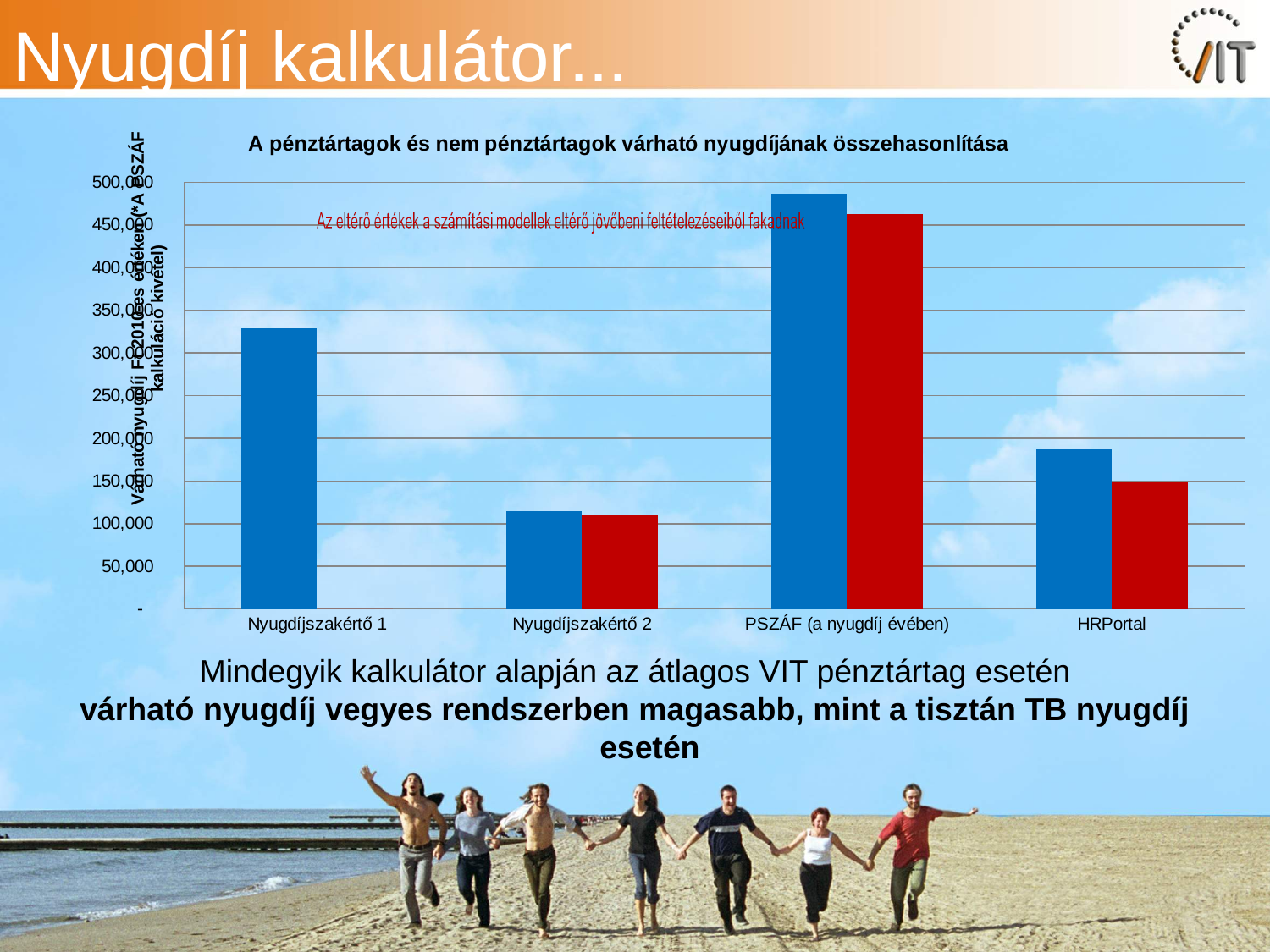
What is the title of the chart? A pénztártagok és nem pénztártagok várható nyugdíjának összehasonlítása Which is larger: the blue bar for Nyugdíjszakértő 1 or the blue bar for HRPortal? Nyugdíjszakértő 1 Is the blue bar for Nyugdíjszakértő 2 greater or less than 150,000? less Which category has the tallest blue bar? PSZÁF (a nyugdíj évében) Which category has the shortest blue bar? Nyugdíjszakértő 2 What kind of chart is shown on the slide? bar chart Is the blue bar for PSZÁF (a nyugdíj évében) greater or less than 450,000? greater For HRPortal, which bar is taller, the blue one or the red one? the blue one Which category has only a blue bar and no red bar? Nyugdíjszakértő 1 How many categories are shown on the x axis of the chart? 4 Is the blue bar for Nyugdíjszakértő 1 greater or less than 300,000? greater